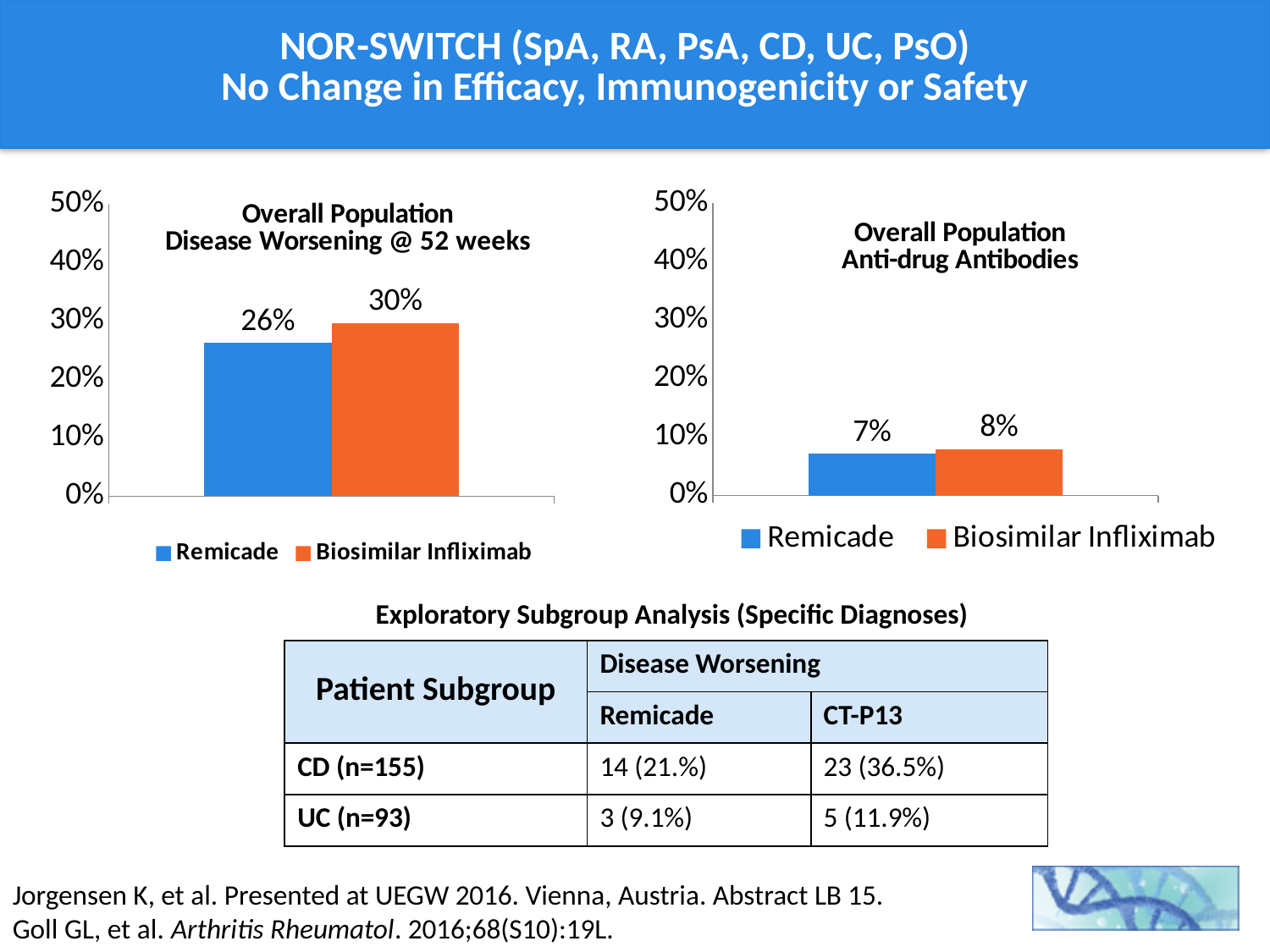
In the 'Overall Population Anti-drug Antibodies' chart, which series has the lower value? Remicade In the 'Overall Population Anti-drug Antibodies' chart, is the value for Biosimilar Infliximab greater or less than 10%? less In the 'Overall Population Disease Worsening @ 52 weeks' chart, is the value for Remicade greater or less than 20%? greater In the 'Overall Population Disease Worsening @ 52 weeks' chart, what is the value for Remicade? 26% In the 'Overall Population Anti-drug Antibodies' chart, what is the value for Remicade? 7% In the 'Overall Population Disease Worsening @ 52 weeks' chart, what is the value for Biosimilar Infliximab? 30% In the 'Overall Population Anti-drug Antibodies' chart, what is the value for Biosimilar Infliximab? 8% In the 'Overall Population Disease Worsening @ 52 weeks' chart, what is the difference between the Biosimilar Infliximab and Remicade values? 4% In the 'Overall Population Anti-drug Antibodies' chart, what is the difference between the Biosimilar Infliximab and Remicade values? 1% In the 'Overall Population Disease Worsening @ 52 weeks' chart, which series has the higher value? Biosimilar Infliximab What kind of chart is the 'Overall Population Disease Worsening @ 52 weeks' chart? Bar chart How many series does the legend of the 'Overall Population Anti-drug Antibodies' chart list? 2